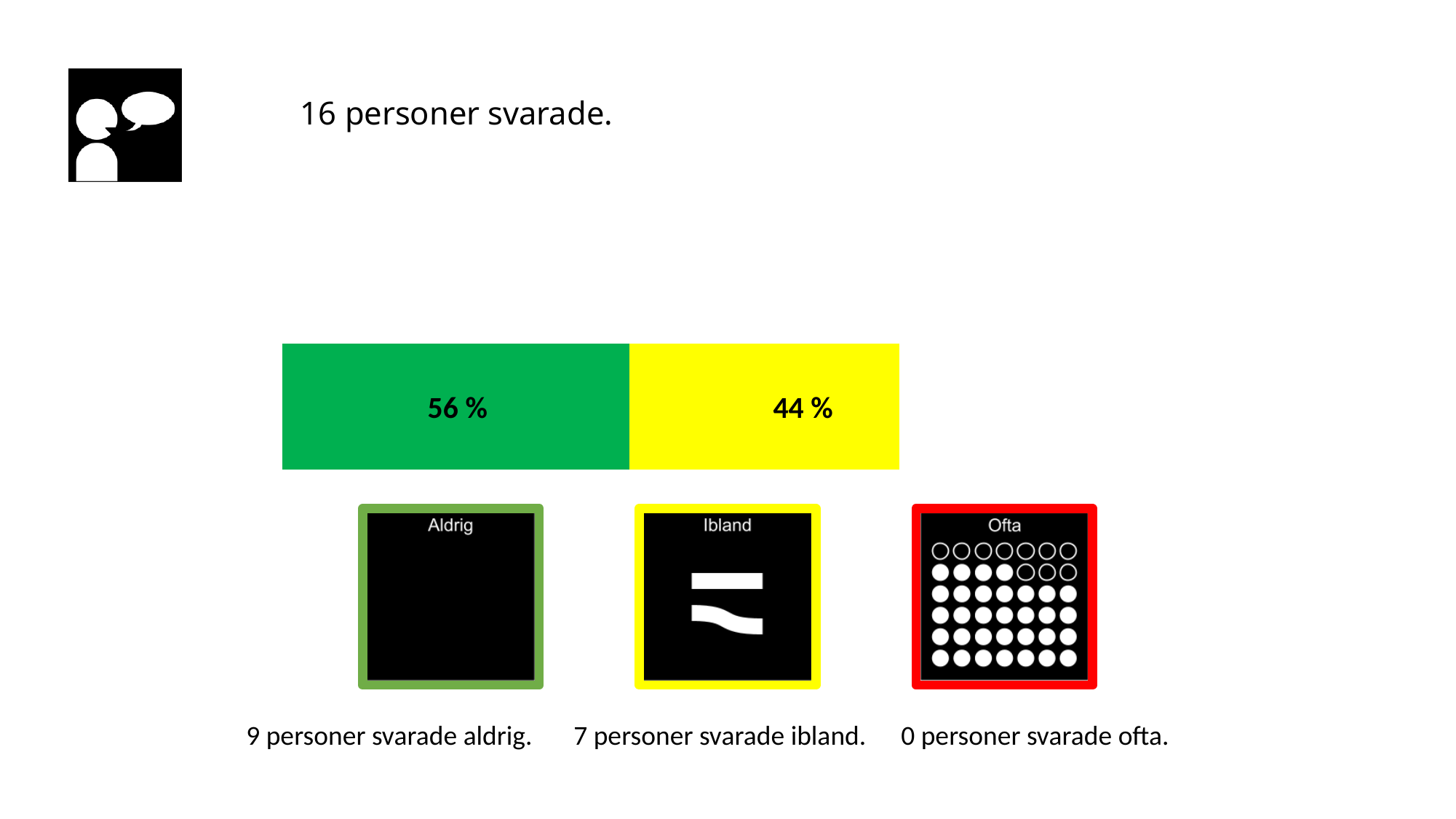
What percentage is shown on the green segment of the bar? 56 % How many people answered 'aldrig' according to the slide? 9 What percentage is shown on the yellow segment of the bar? 44 % What is the difference between the green segment's percentage and the yellow segment's percentage? 12 % Which segment of the bar is larger, the green one or the yellow one? the green one What is the total of the two segments in the stacked bar? 100 % How many segments does the bar have? 2 Is the yellow segment's value greater or less than 50 %? less How many people answered 'ofta' according to the slide? 0 Is the green segment's value greater or less than 50 %? greater What colour is the segment labelled 56 %? green What kind of chart is shown on the slide? a stacked bar chart